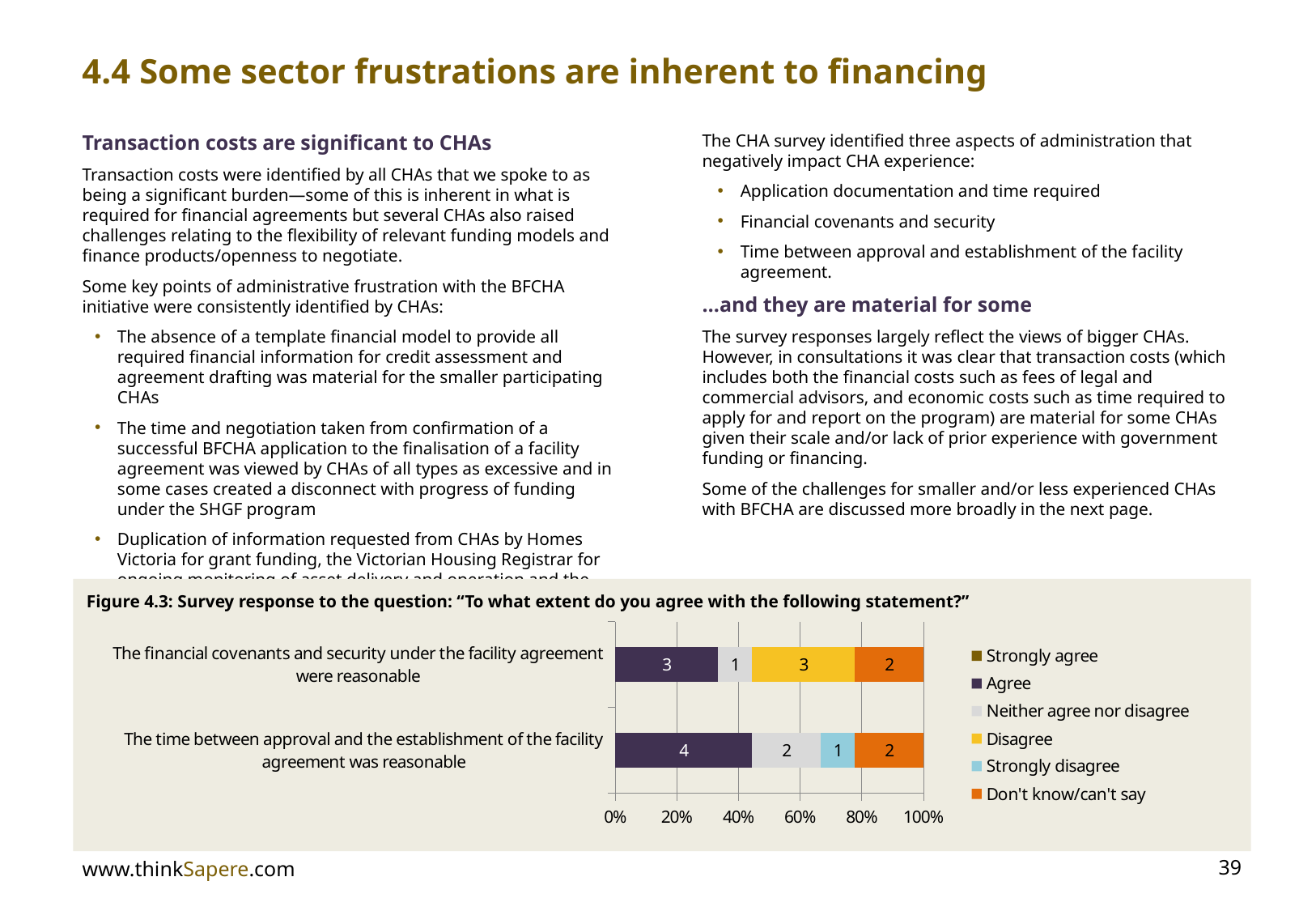
In Figure 4.3, what is the total number of responses for the statement 'The financial covenants and security under the facility agreement were reasonable'? 9 In Figure 4.3, how many respondents answered 'Strongly disagree' for the statement 'The time between approval and the establishment of the facility agreement was reasonable'? 1 In Figure 4.3, what is the total number of responses for the statement 'The time between approval and the establishment of the facility agreement was reasonable'? 9 In Figure 4.3, how many respondents answered 'Don't know/can't say' for the statement about the time between approval and establishment of the facility agreement? 2 What kind of chart is shown in Figure 4.3? Stacked bar chart In Figure 4.3, how many respondents answered 'Agree' for the statement 'The time between approval and the establishment of the facility agreement was reasonable'? 4 In Figure 4.3, how many respondents answered 'Disagree' for the statement 'The financial covenants and security under the facility agreement were reasonable'? 3 In Figure 4.3, which statement received more 'Agree' responses? The time between approval and the establishment of the facility agreement was reasonable In Figure 4.3, how many respondents answered 'Agree' for the statement 'The financial covenants and security under the facility agreement were reasonable'? 3 How many statements (categories) are plotted in Figure 4.3? 2 How many series does the legend of Figure 4.3 list? 6 In Figure 4.3, what is the difference between the 'Neither agree nor disagree' counts for the two statements? 1